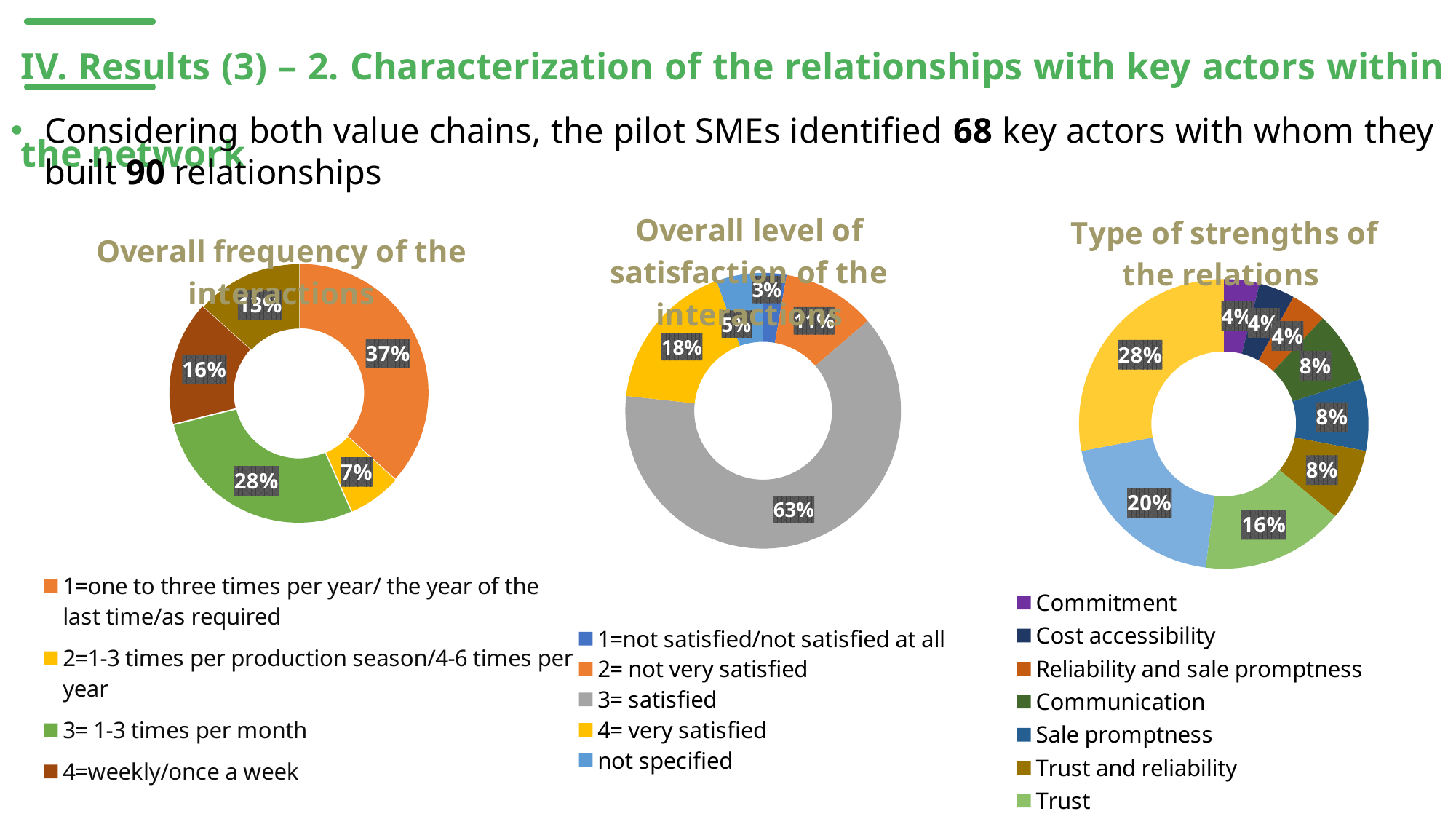
What type of chart is the 'Type of strengths of the relations' chart? Doughnut (pie) chart In the 'Overall frequency of the interactions' chart, what is the difference between the 37% slice and the 28% slice? 9 percentage points In the 'Type of strengths of the relations' chart, what percentage is shown for 'Trust'? 16% How many entries does the legend of the 'Type of strengths of the relations' chart list? 7 In the 'Overall frequency of the interactions' chart, what percentage is shown for '3= 1-3 times per month'? 28% In the 'Overall level of satisfaction of the interactions' chart, what is the difference between '3= satisfied' and '4= very satisfied'? 45 percentage points In the 'Overall frequency of the interactions' chart, what percentage is shown for '4=weekly/once a week'? 16% In the 'Overall frequency of the interactions' chart, which legend category has the largest share? 1=one to three times per year/ the year of the last time/as required How many slices does the 'Overall level of satisfaction of the interactions' chart have? 5 In the 'Overall level of satisfaction of the interactions' chart, which is larger: '2= not very satisfied' or 'not specified'? 2= not very satisfied In the 'Overall level of satisfaction of the interactions' chart, what percentage is shown for '3= satisfied'? 63% In the 'Overall level of satisfaction of the interactions' chart, which category has the smallest share? 1=not satisfied/not satisfied at all